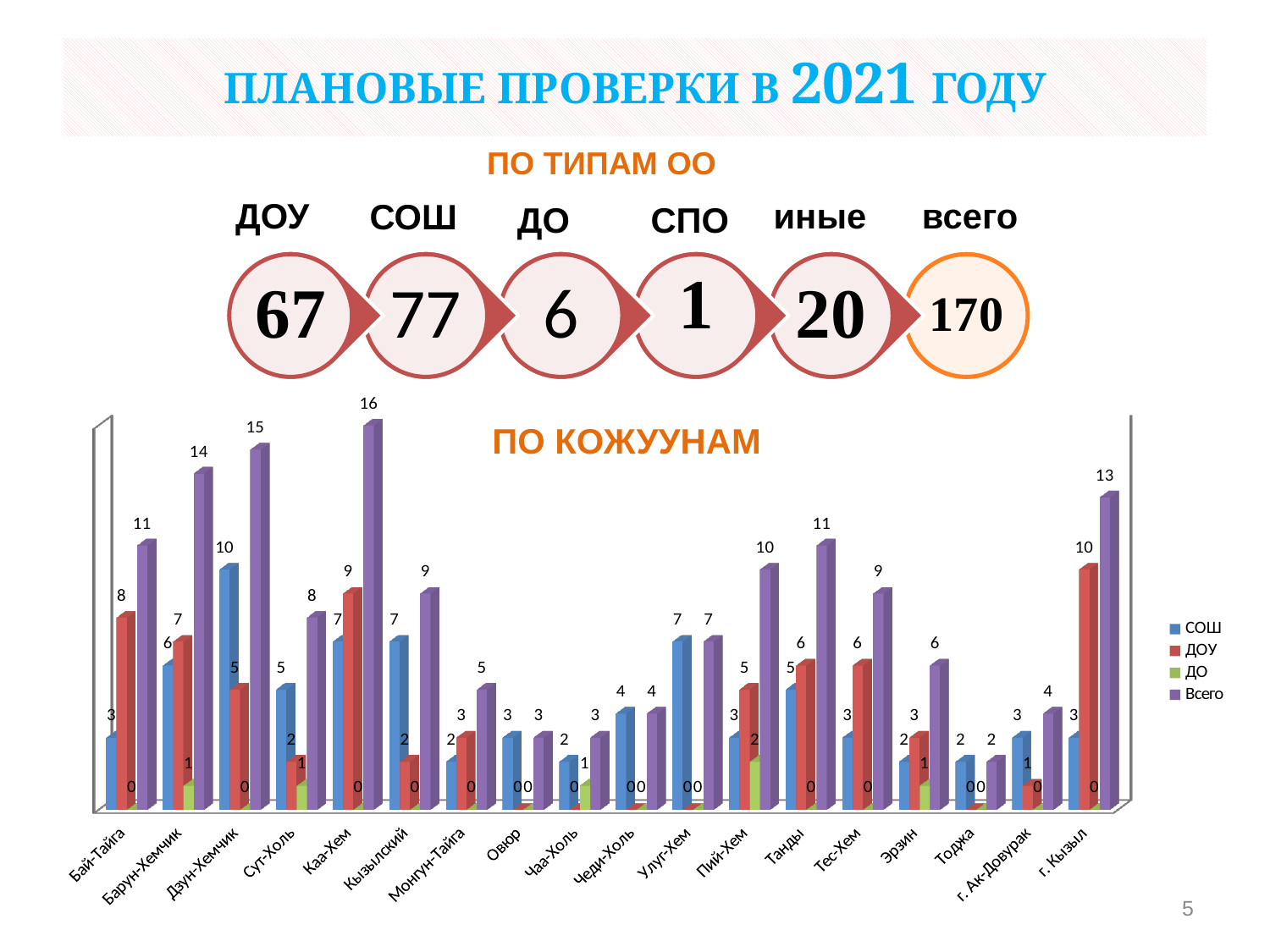
In the ПО КОЖУУНАМ chart, what is the ДОУ value for г. Кызыл? 10 In the ПО КОЖУУНАМ chart, what is the ДО value for Пий-Хем? 2 In the ПО КОЖУУНАМ chart, which kozhuun has the lowest Всего value? Тоджа In the ПО КОЖУУНАМ chart, which is larger: the ДОУ value for Бай-Тайга or the ДОУ value for Барун-Хемчик? Бай-Тайга In the ПО КОЖУУНАМ chart, what is the difference between the Всего values for Дзун-Хемчик and Бай-Тайга? 4 How many kozhuuns (categories) are shown on the x axis of the ПО КОЖУУНАМ chart? 18 What kind of chart is shown under the heading ПО КОЖУУНАМ? bar chart In the ПО КОЖУУНАМ chart, what is the Всего value for Каа-Хем? 16 In the ПО КОЖУУНАМ chart, which kozhuun has the highest Всего value? Каа-Хем Which series in the ПО КОЖУУНАМ chart is shown in purple? Всего How many series does the legend of the ПО КОЖУУНАМ chart list? 4 In the ПО КОЖУУНАМ chart, what is the СОШ value for Дзун-Хемчик? 10